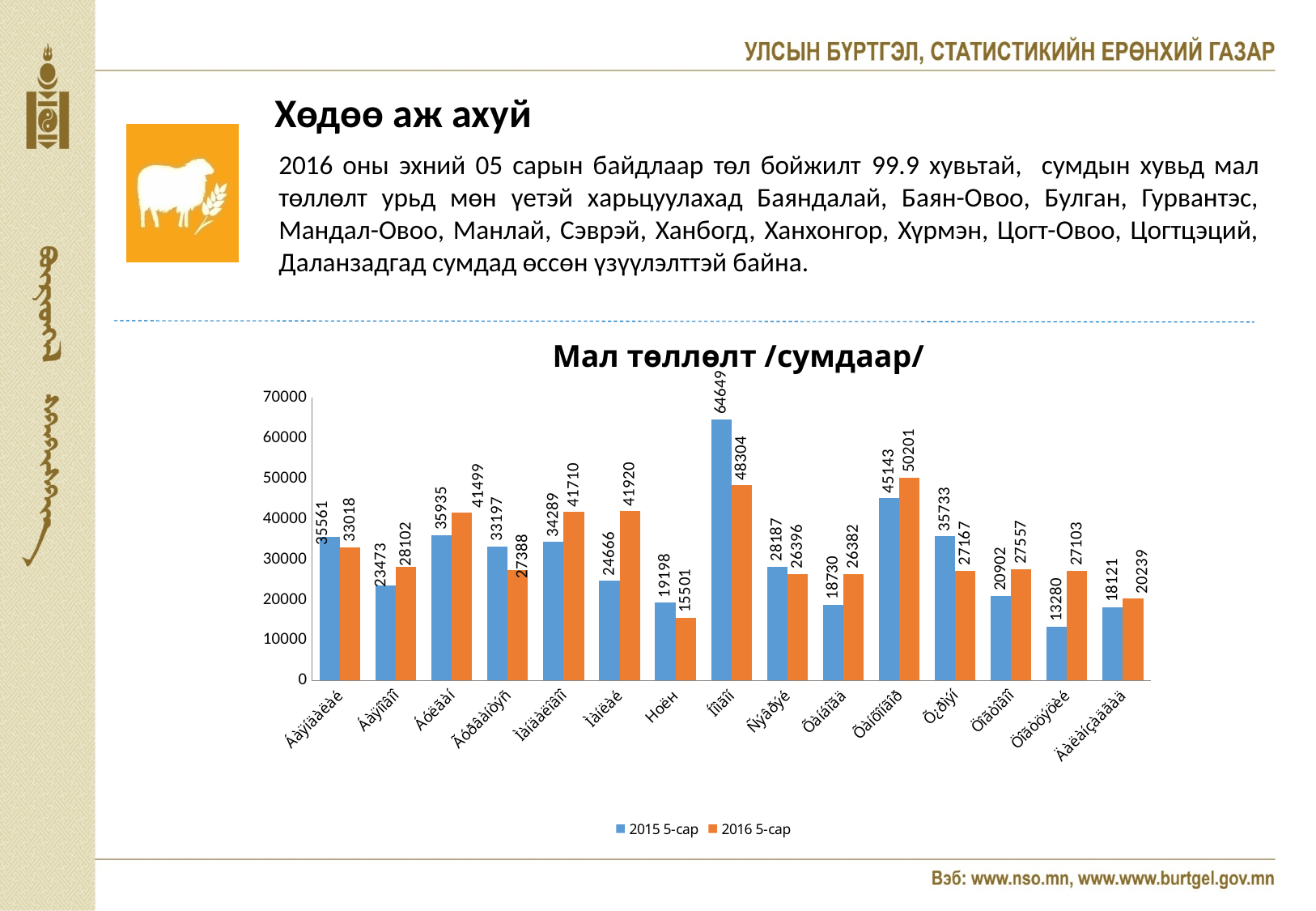
How many series does the chart legend list? 2 What are the two series named in the legend? 2015 5-сар and 2016 5-сар What is the highest value shown for the 2015 5-сар series? 64649 How many categories are plotted along the x axis? 15 For Ноён, which series has the larger value, 2015 5-сар or 2016 5-сар? 2015 5-сар What is the difference between the 2015 5-сар and 2016 5-сар values for Ноён? 3697 What is the title of the chart? Мал төллөлт /сумдаар/ Is the 2015 5-сар value for Ноён greater or less than 20000? less What is the 2016 5-сар value for Ноён? 15501 What kind of chart is shown on the slide? bar chart What is the highest value shown for the 2016 5-сар series? 50201 What is the 2015 5-сар value for Ноён? 19198